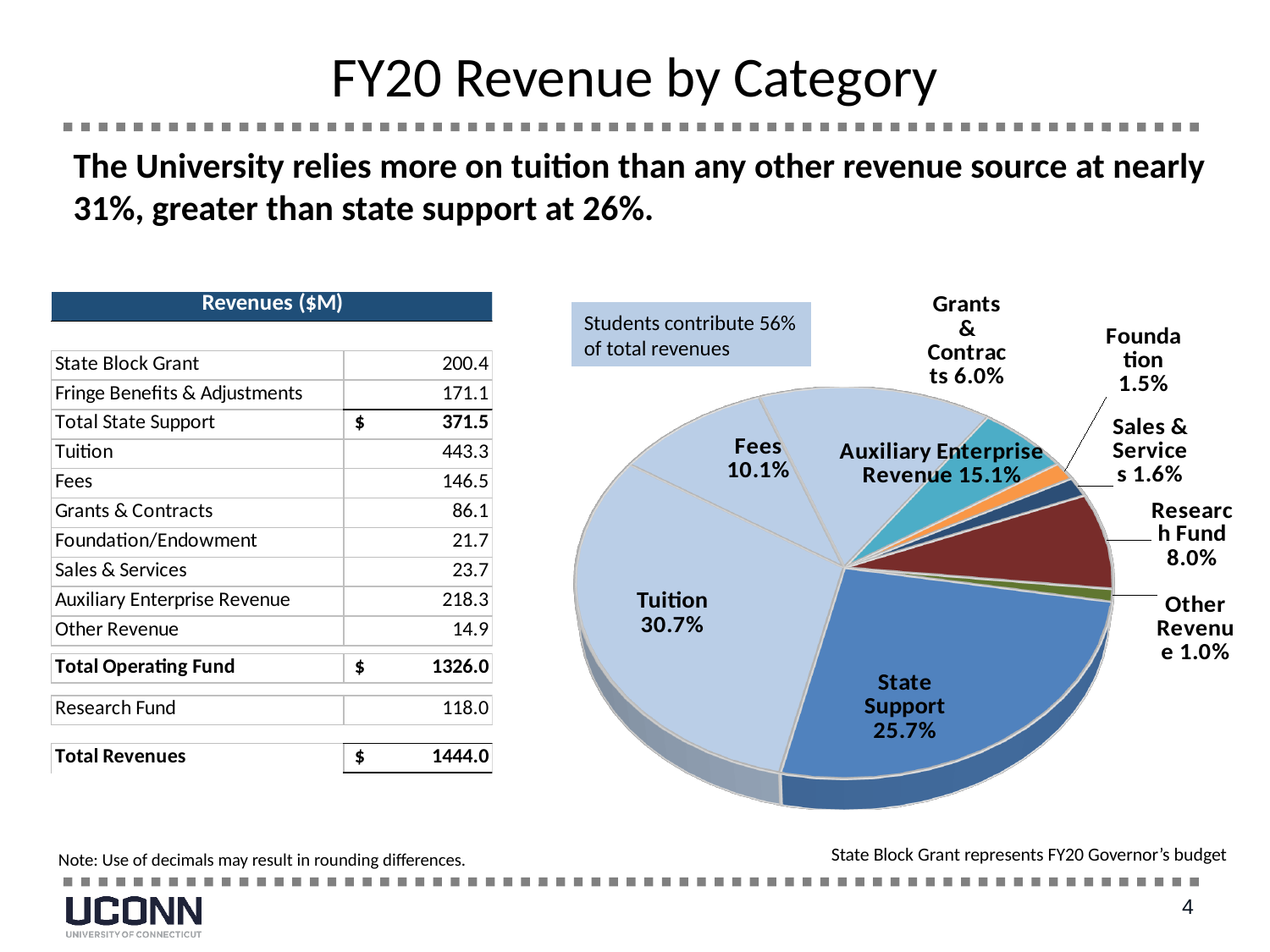
What is the difference in percentage points between Tuition and State Support in the pie chart? 5.0 What share of the pie does Tuition represent? 30.7% Which category has the smallest slice of the pie chart? Other Revenue Which category has the largest slice of the pie chart? Tuition What is the combined share of Tuition and Fees in the pie chart? 40.8% How many slices does the pie chart have? 9 What percentage is shown for Research Fund in the pie chart? 8.0% What kind of chart is shown on the slide? pie chart Which is larger in the pie chart, Fees or Grants & Contracts? Fees What is the title of the slide containing the pie chart? FY20 Revenue by Category What percentage is shown for State Support in the pie chart? 25.7% What percentage is shown for Auxiliary Enterprise Revenue in the pie chart? 15.1%